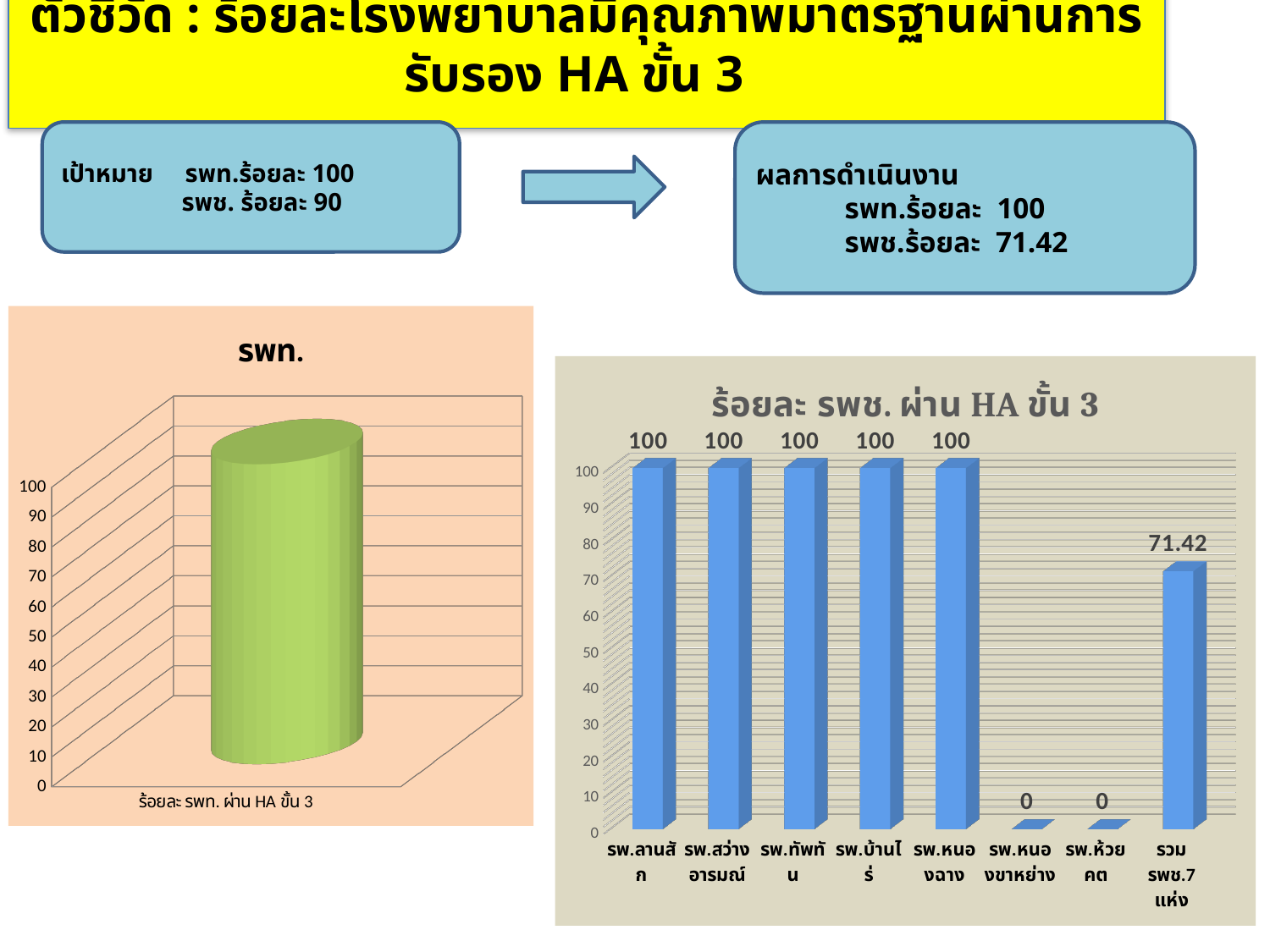
In the chart titled 'ร้อยละ รพช. ผ่าน HA ขั้น 3', is the value for รวม รพช.7 แห่ง greater or less than 80? less In the chart titled 'ร้อยละ รพช. ผ่าน HA ขั้น 3', what is the value for รพ.หนองขาหย่าง? 0 What kind of chart is the chart titled 'ร้อยละ รพช. ผ่าน HA ขั้น 3'? bar chart In the chart titled 'ร้อยละ รพช. ผ่าน HA ขั้น 3', what is the value for รพ.ลานสัก? 100 In the chart titled 'ร้อยละ รพช. ผ่าน HA ขั้น 3', how many categories are shown on the x axis? 8 In the chart titled 'ร้อยละ รพช. ผ่าน HA ขั้น 3', which is larger: the value for รพ.บ้านไร่ or the value for รวม รพช.7 แห่ง? รพ.บ้านไร่ In the chart titled 'ร้อยละ รพช. ผ่าน HA ขั้น 3', how many categories have a value of 0? 2 What is the title of the chart on the right side of the slide? ร้อยละ รพช. ผ่าน HA ขั้น 3 In the chart titled 'รพท.' on the left, is the value for ร้อยละ รพท. ผ่าน HA ขั้น 3 greater or less than 50? greater In the chart titled 'ร้อยละ รพช. ผ่าน HA ขั้น 3', what is the value for รวม รพช.7 แห่ง? 71.42 In the chart titled 'ร้อยละ รพช. ผ่าน HA ขั้น 3', what is the value for รพ.ห้วยคต? 0 In the chart titled 'ร้อยละ รพช. ผ่าน HA ขั้น 3', what is the difference between the value for รพ.หนองฉาง and the value for รวม รพช.7 แห่ง? 28.58